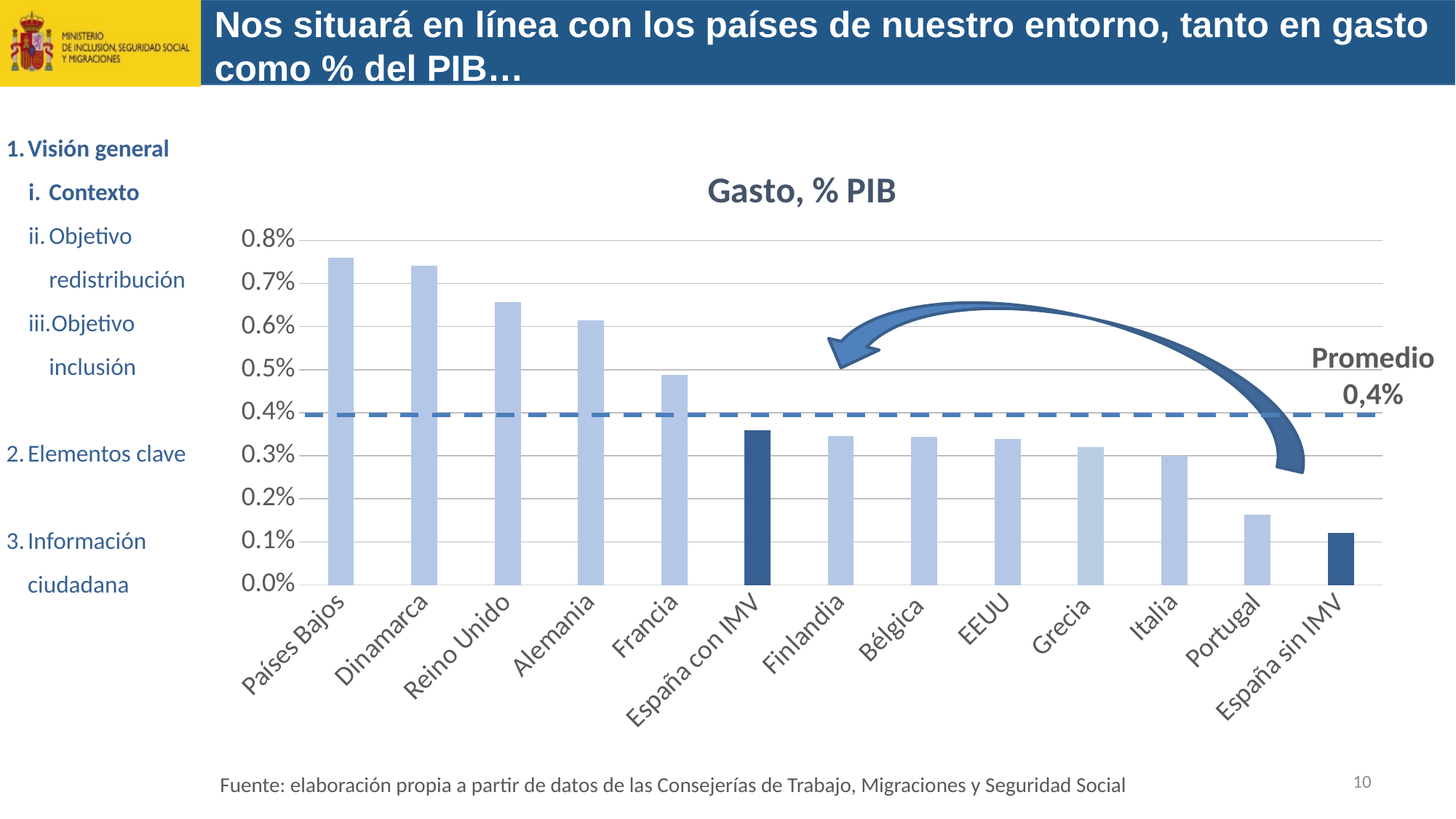
Is the value for Francia greater or less than 0.4%? greater What value does the dashed horizontal line labelled 'Promedio' mark? 0,4% What kind of chart is shown on the slide? bar chart Is the value for Portugal greater or less than 0.2%? less Which category has the lowest value in the chart? España sin IMV Which has a higher value, Reino Unido or Francia? Reino Unido How many countries/categories are plotted in the chart? 13 Do the values generally rise or fall from left to right across the categories? fall What is the title of the chart? Gasto, % PIB Is the value for Países Bajos greater or less than 0.7%? greater